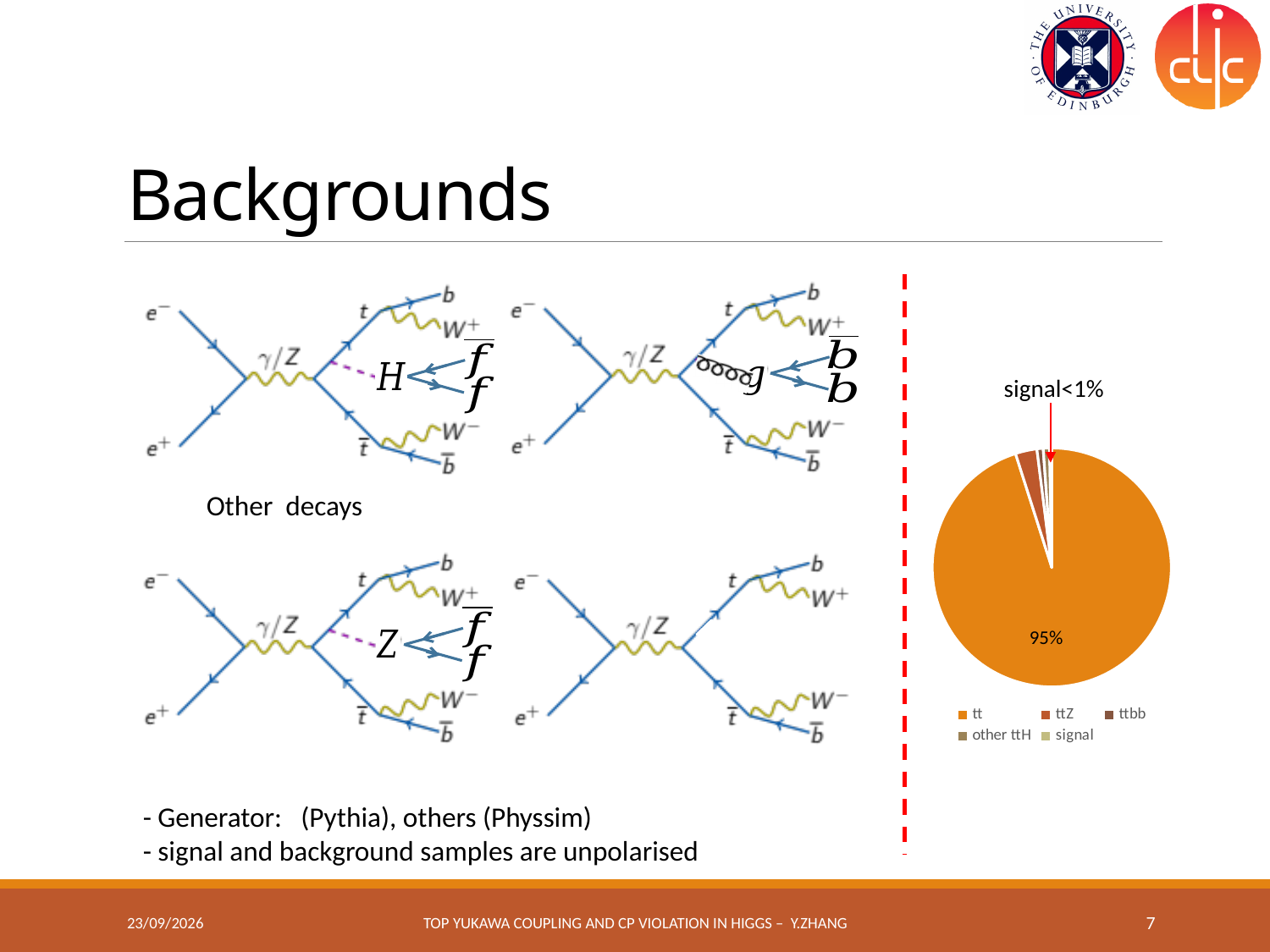
What share of the pie chart does the tt slice take? 95% What does the annotation with the red arrow on the pie chart say? signal<1% Which is larger in the pie chart, the tt slice or the ttZ slice? tt Is the share of the tt slice in the pie chart greater or less than 50%? greater What kind of chart is shown on the right side of the slide? pie chart What colour is the tt slice in the pie chart? orange How many categories does the legend of the pie chart list? 5 Which legend entry in the pie chart is listed immediately after ttZ? ttbb Which category has the largest slice in the pie chart? tt